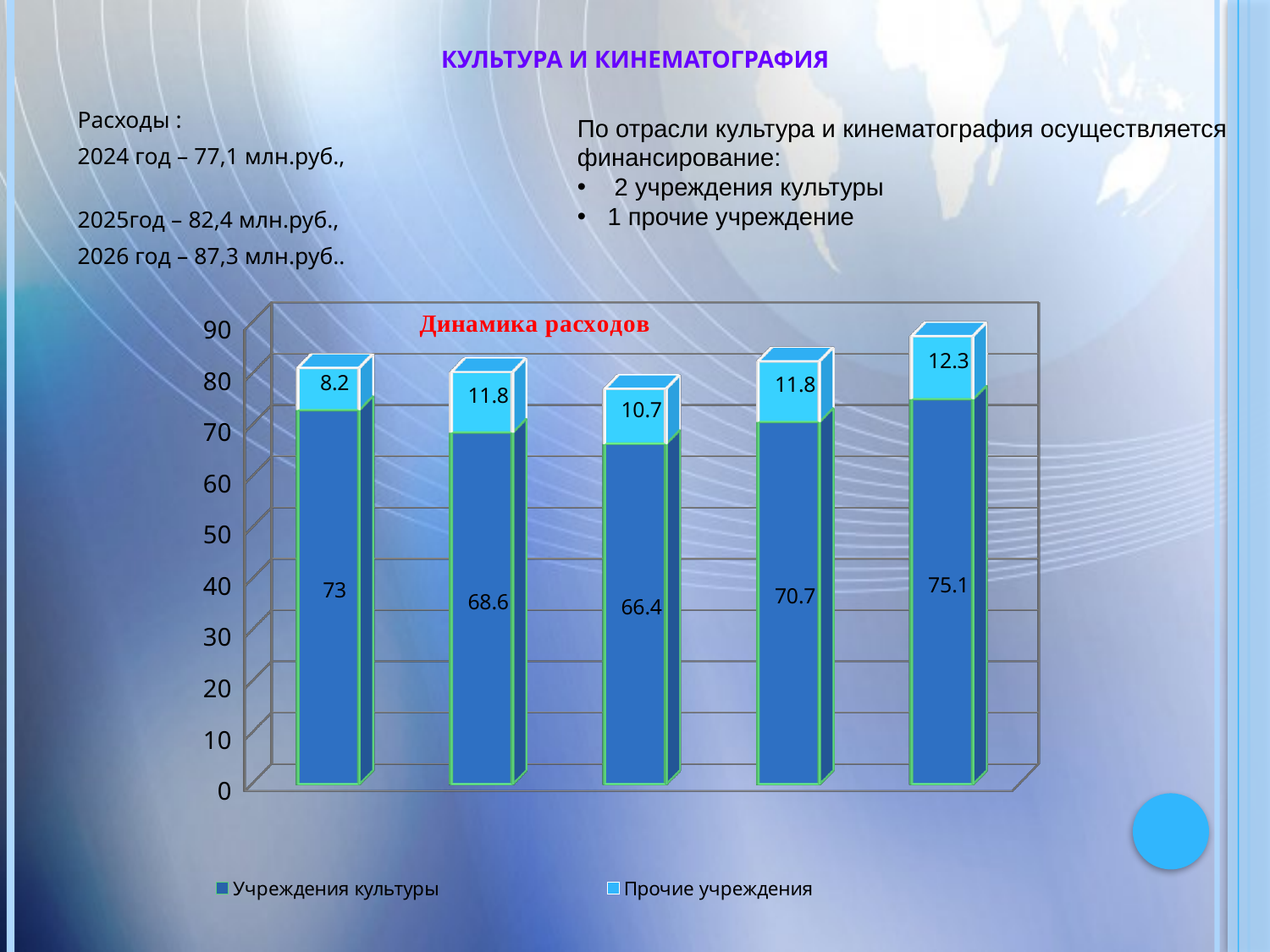
What is the title of the chart? Динамика расходов Which bar has the lowest Прочие учреждения value? the first bar from the left (8.2) Which bar has the highest Учреждения культуры value? the fifth bar from the left (75.1) What kind of chart is shown on the slide? bar chart How many series does the legend of the chart list? 2 What is the difference between the Учреждения культуры values of the fifth and third bars from the left? 8.7 How many bars are plotted in the chart? 5 What is the value of the Учреждения культуры segment in the first bar from the left? 73 What is the total of the fifth bar from the left (Учреждения культуры plus Прочие учреждения)? 87.4 What is the value of the Учреждения культуры segment in the fifth bar from the left? 75.1 What is the value of the Прочие учреждения segment in the third bar from the left? 10.7 Which is larger: the Прочие учреждения value in the second bar or in the third bar from the left? the second bar (11.8)